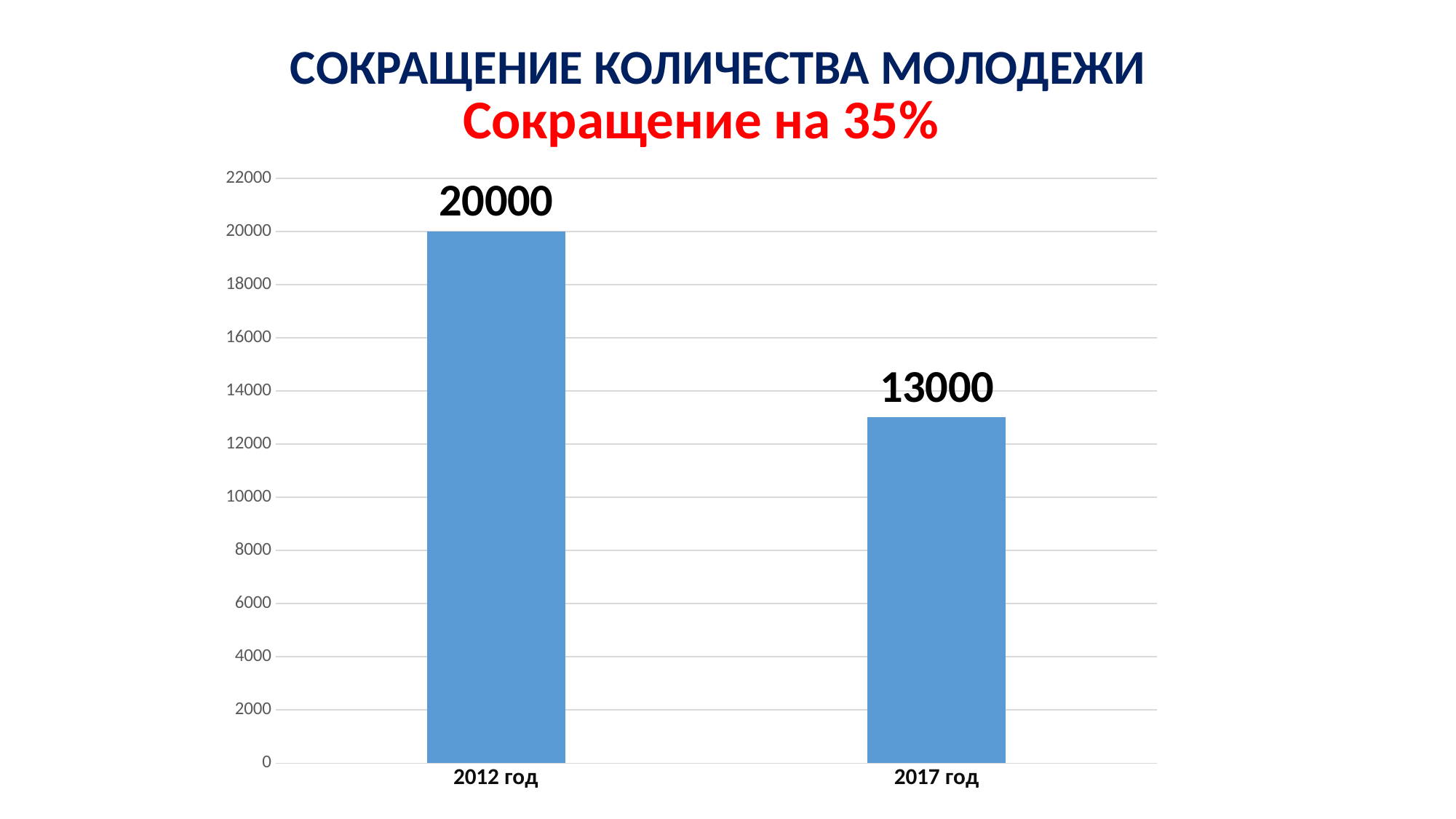
What is the value for 2012 год? 20000 Which category has the lowest value? 2017 год Is the value for 2017 год greater or less than 14000? less What percentage reduction does the red subtitle state? 35% What is the difference between the values for 2012 год and 2017 год? 7000 Do the values rise or fall from 2012 год to 2017 год? fall Which is larger, the value for 2012 год or the value for 2017 год? 2012 год Which category has the highest value? 2012 год How many categories are shown on the x axis? 2 What kind of chart is shown on the slide? bar chart Is the value for 2012 год greater or less than 18000? greater What is the value for 2017 год? 13000